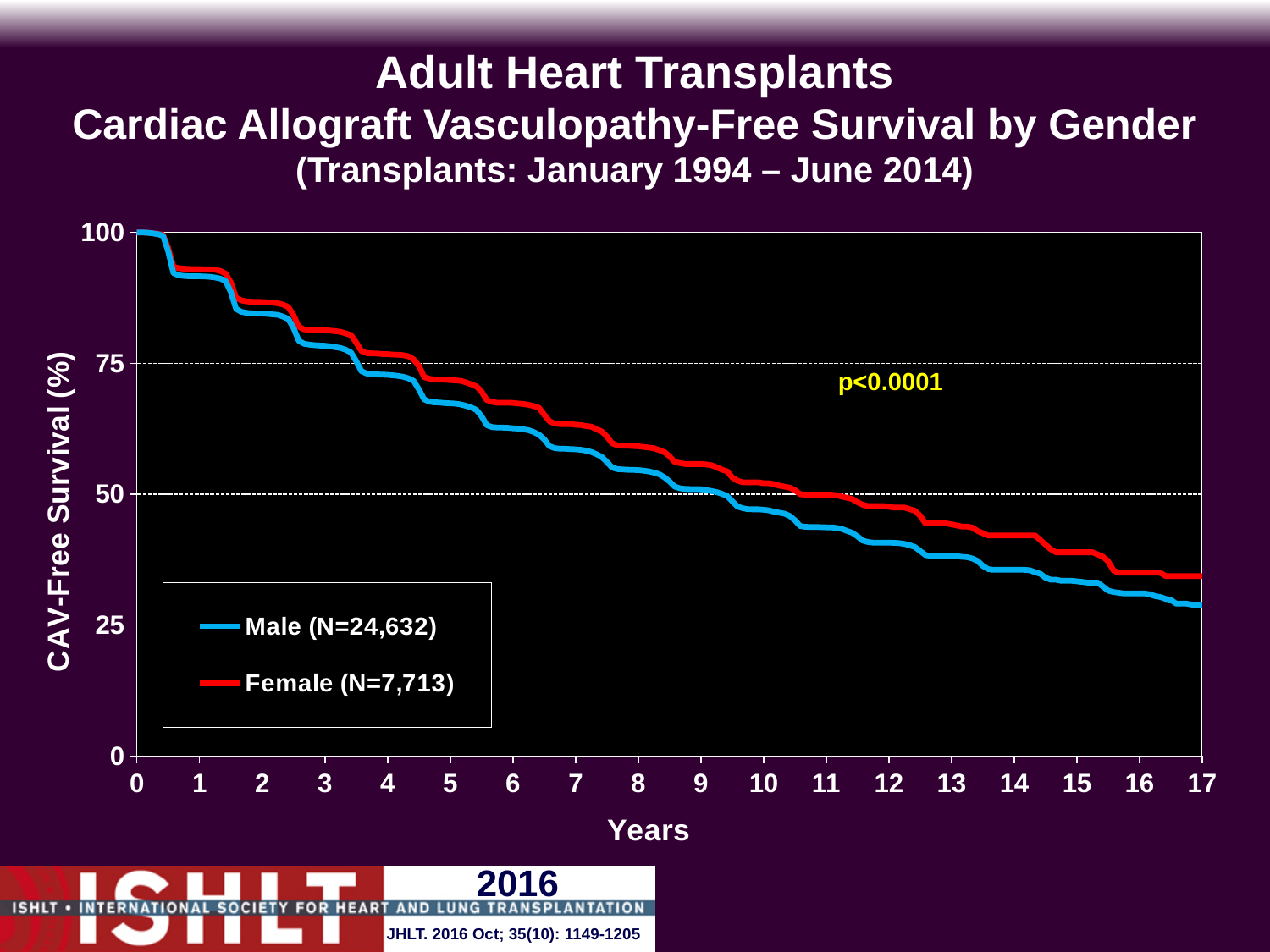
Is the value for Female at year 3 greater or less than 75? greater What p-value is printed on the chart? p<0.0001 Is the value for Male at year 5 greater or less than 75? less What kind of chart is shown on the slide? line chart At year 15, which series has the higher CAV-free survival, Male or Female? Female Is the value for Male at year 17 greater or less than 25? greater What is the N for the Female series shown in the legend? N=7,713 What is the CAV-free survival value for both Male and Female at year 0? 100 Do the CAV-free survival values rise or fall as the years increase? fall How many series does the legend list? 2